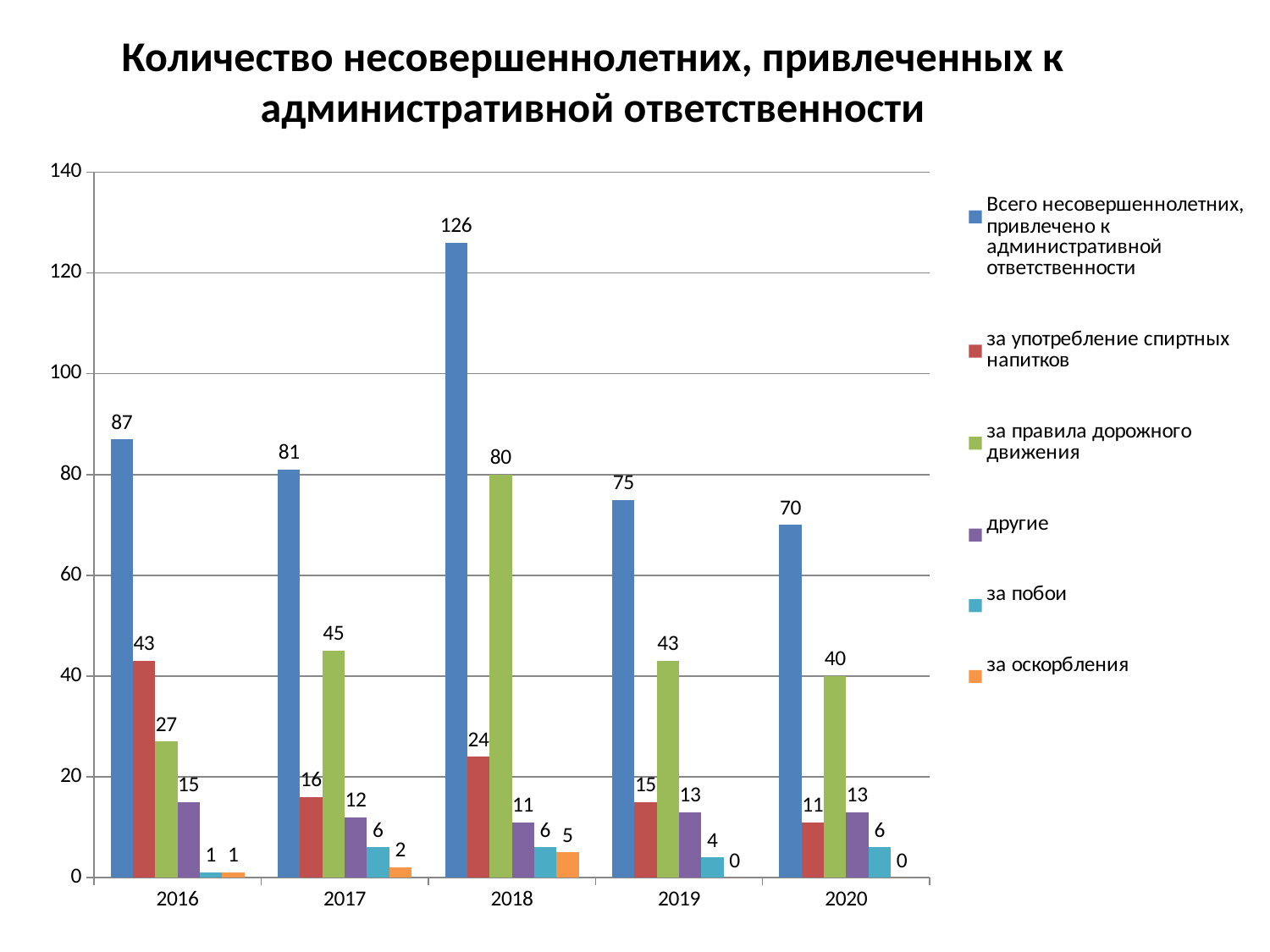
What kind of chart is shown on the slide? bar chart In which year is the total number of minors brought to administrative responsibility the lowest? 2020 What is the value for 'за правила дорожного движения' in 2017? 45 Which is larger in 2019: the value for 'за употребление спиртных напитков' or for 'другие'? за употребление спиртных напитков How many years are shown on the x axis? 5 What is the difference between the total number of minors in 2018 and in 2019? 51 What colour represents 'за побои' in the legend? light blue What is the value for 'за оскорбления' in 2020? 0 How many series does the legend list? 6 What is the value for 'за употребление спиртных напитков' in 2016? 43 What is the total number of minors brought to administrative responsibility (Всего несовершеннолетних) in 2018? 126 In which year is the total number of minors brought to administrative responsibility the highest? 2018